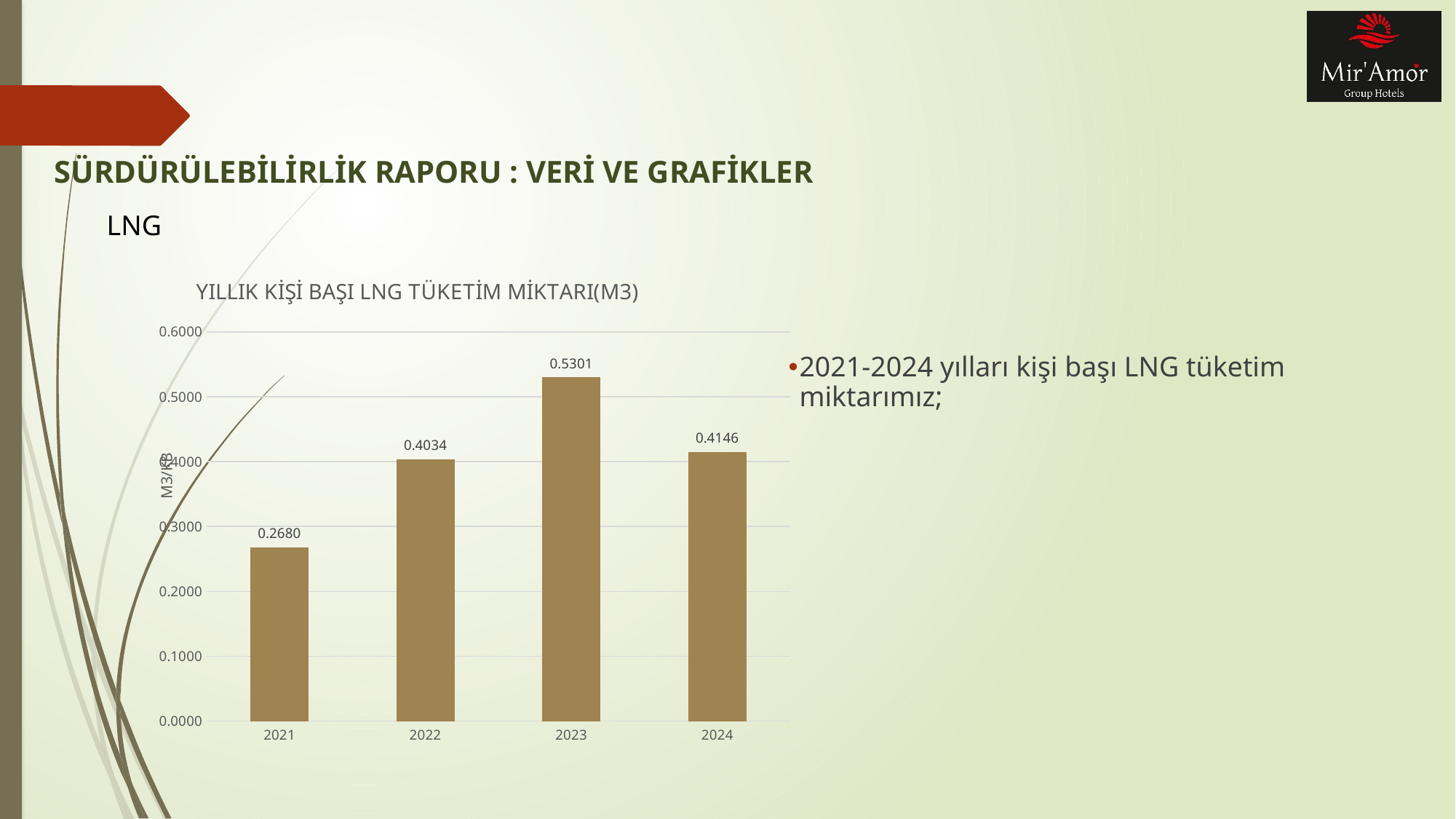
Which year has the highest value in the chart? 2023 Which is larger, the value for 2022 or the value for 2024? 2024 How many years are shown on the x axis of the chart? 4 What is the value for 2023 in the chart? 0.5301 What kind of chart is shown on the slide? bar chart What is the value for 2024 in the chart? 0.4146 What is the difference between the values for 2024 and 2021? 0.1466 What is the difference between the values for 2023 and 2022? 0.1267 What is the value for 2021 in the chart? 0.2680 Is the value for 2021 greater or less than 0.3000? less Which year has the lowest value in the chart? 2021 What is the title of the chart? YILLIK KİŞİ BAŞI LNG TÜKETİM MİKTARI(M3)